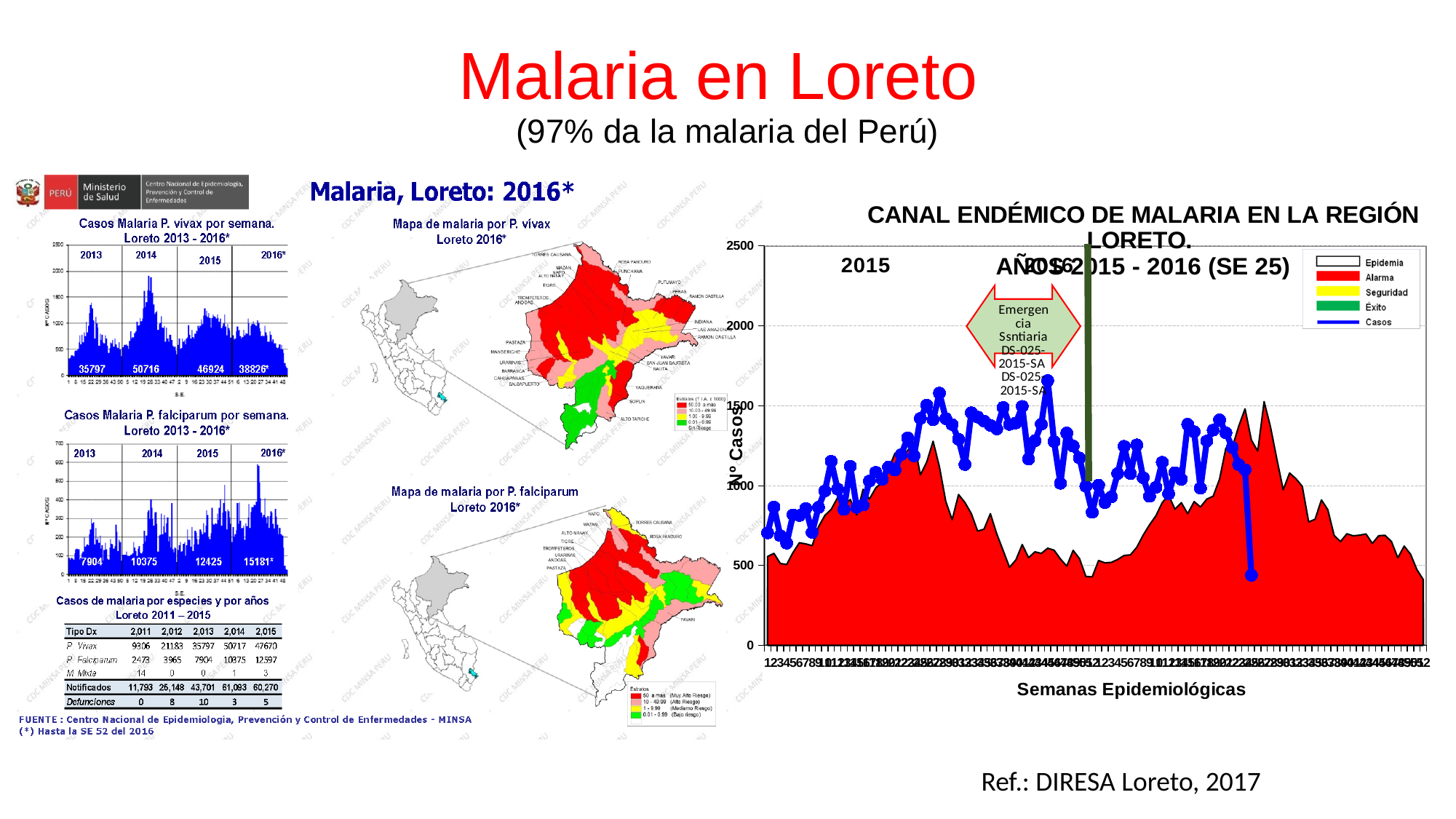
In the chart 'Casos Malaria P. vivax por semana. Loreto 2013 - 2016*', what is the difference between the printed totals for 2014 and 2015? 3792 In the chart 'Casos Malaria P. vivax por semana. Loreto 2013 - 2016*', what is the total number of cases printed for 2014? 50716 In the chart 'CANAL ENDÉMICO DE MALARIA EN LA REGIÓN LORETO', how many entries does the legend list? 5 In the chart 'Casos Malaria P. falciparum por semana. Loreto 2013 - 2016*', which year has the highest printed total of cases? 2016* In the chart 'Casos Malaria P. vivax por semana. Loreto 2013 - 2016*', which year has the lowest printed total of cases? 2013 In the chart 'Casos Malaria P. falciparum por semana. Loreto 2013 - 2016*', what is the difference between the printed totals for 2015 and 2014? 2050 In the chart 'Casos Malaria P. falciparum por semana. Loreto 2013 - 2016*', do the printed annual totals rise or fall from 2013 to 2016*? rise What kind of chart is 'Casos Malaria P. vivax por semana. Loreto 2013 - 2016*'? bar chart In the chart 'CANAL ENDÉMICO DE MALARIA EN LA REGIÓN LORETO', what is the label of the vertical axis? N° Casos In the chart 'Casos Malaria P. vivax por semana. Loreto 2013 - 2016*', which year has the highest printed total of cases? 2014 In the chart 'Casos Malaria P. vivax por semana. Loreto 2013 - 2016*', how many years are shown? 4 In the chart 'Casos Malaria P. falciparum por semana. Loreto 2013 - 2016*', what is the total number of cases printed for 2016*? 15181*